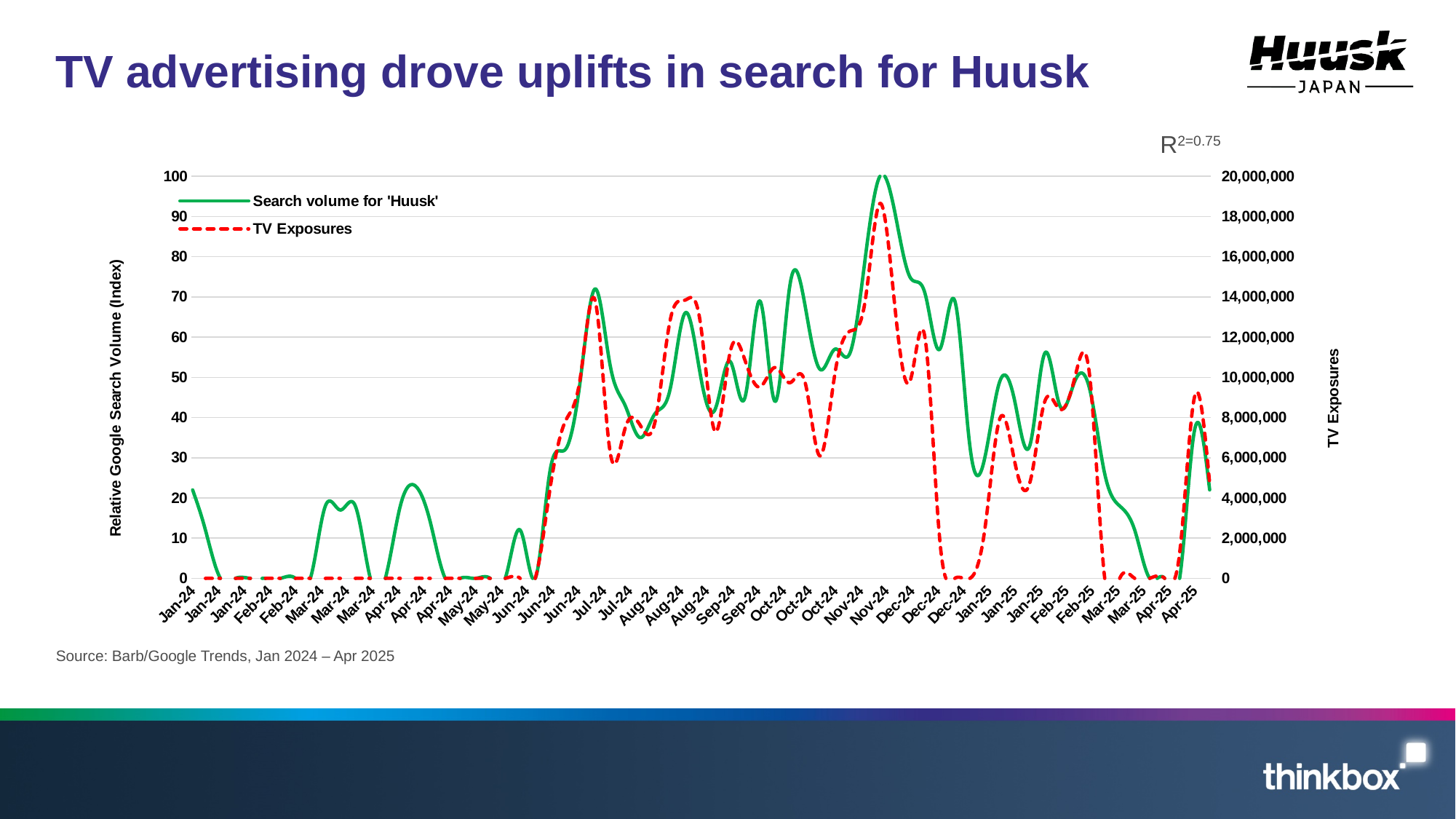
Are TV Exposures in Feb-24 greater or less than 2,000,000? less Does the search volume for 'Huusk' generally rise or fall between Nov-24 and Mar-25? fall What is the title of the slide? TV advertising drove uplifts in search for Huusk What kind of chart is shown on the slide? Line chart Is the search volume for 'Huusk' at its Jul-24 peak greater or less than 60? greater Does the search volume for 'Huusk' generally rise or fall between Jun-24 and Nov-24? rise What R-squared value is shown on the chart? R2=0.75 In which month does the search volume for 'Huusk' reach its highest point? Nov-24 Is the search volume for 'Huusk' at the final Apr-25 point greater or less than 30? less How many series does the chart's legend list? 2 What is the peak value of the search volume for 'Huusk' index, reached in Nov-24? 100